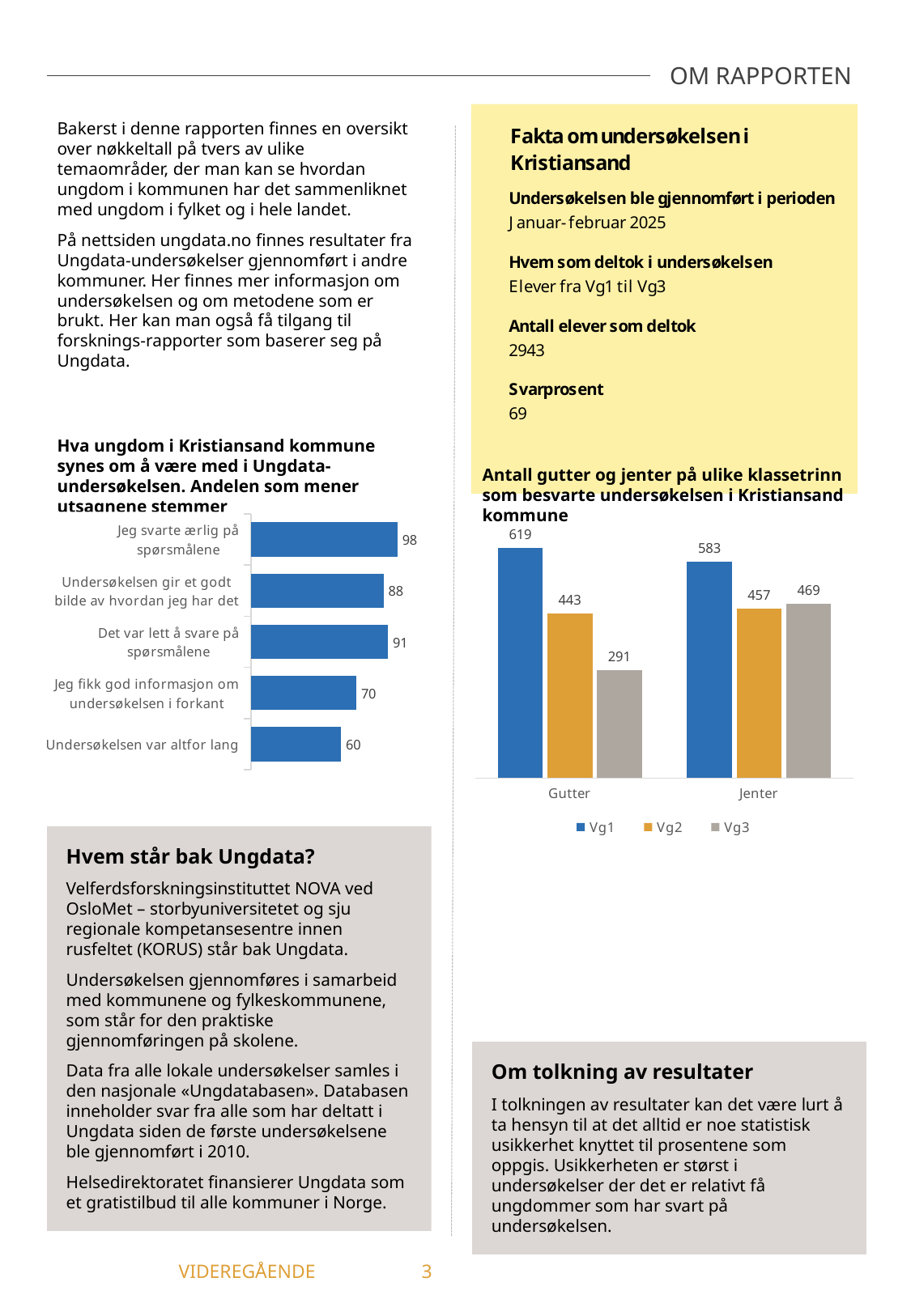
In the chart "Antall gutter og jenter på ulike klassetrinn", which bar is the highest? Vg1 among Gutter In the left chart on what youth think about the Ungdata survey, what is the difference between "Det var lett å svare på spørsmålene" and "Jeg fikk god informasjon om undersøkelsen i forkant"? 21 In the left chart on what youth think about the Ungdata survey, how many statements are shown? 5 In the chart "Antall gutter og jenter på ulike klassetrinn", what is the value for Vg3 among Gutter? 291 In the chart "Antall gutter og jenter på ulike klassetrinn", what is the value for Vg2 among Jenter? 457 What kind of chart is the left chart on what youth think about the Ungdata survey? Bar chart In the chart "Antall gutter og jenter på ulike klassetrinn", which is larger: Vg3 for Gutter or Vg3 for Jenter? Vg3 for Jenter In the chart "Antall gutter og jenter på ulike klassetrinn", what colour are the Vg2 bars? Orange In the left chart on what youth think about the Ungdata survey, which statement has the lowest value? Undersøkelsen var altfor lang In the left chart on what youth in Kristiansand think about taking part in the Ungdata survey, what is the value for "Jeg svarte ærlig på spørsmålene"? 98 How many series does the legend list in the chart "Antall gutter og jenter på ulike klassetrinn"? 3 In the chart "Antall gutter og jenter på ulike klassetrinn", what is the difference between Vg1 for Gutter and Vg1 for Jenter? 36